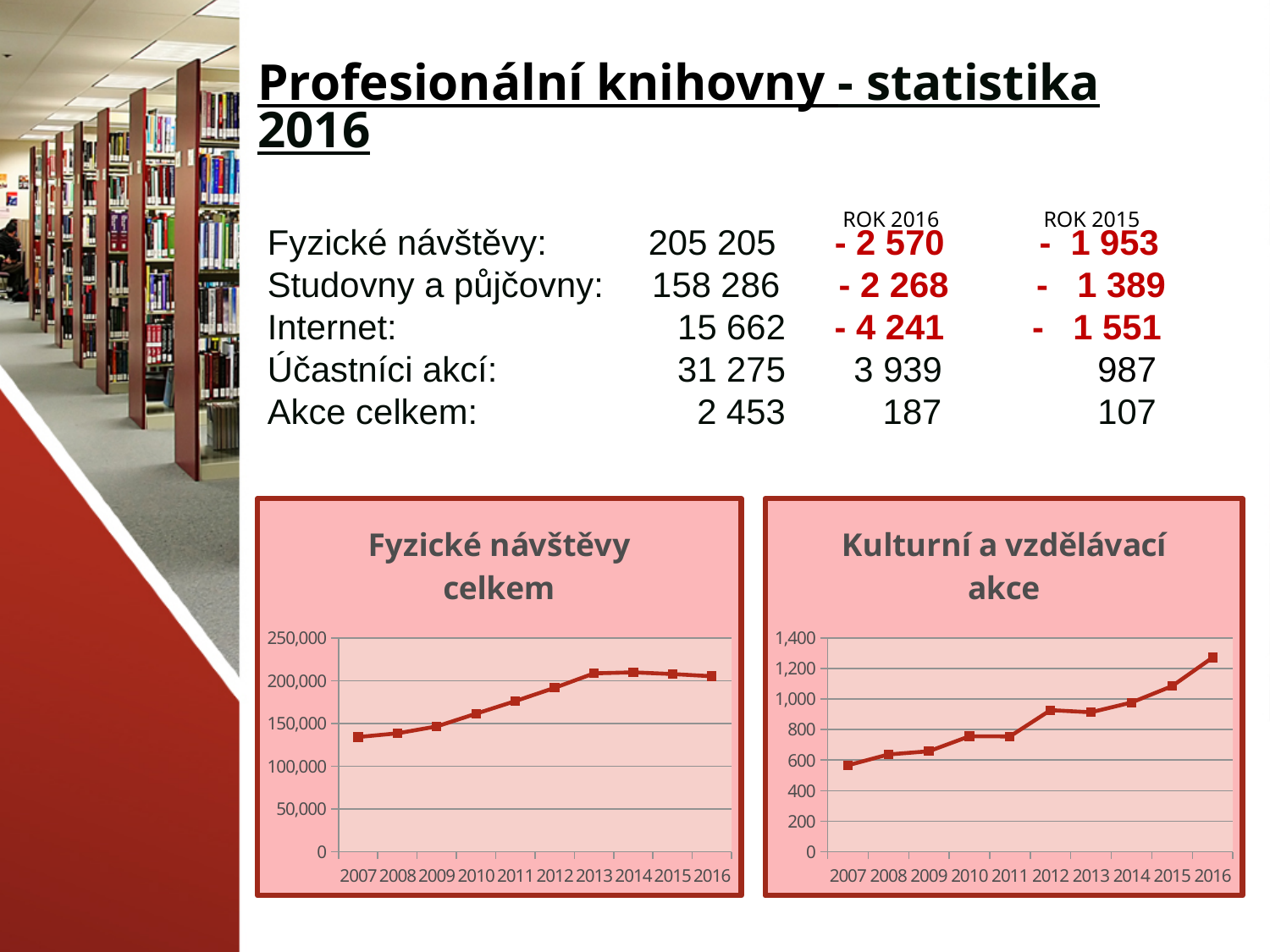
In the "Kulturní a vzdělávací akce" chart, do the values generally rise or fall from 2007 to 2016? rise In the "Fyzické návštěvy celkem" chart, which year has the lowest value? 2007 What kind of chart is the "Fyzické návštěvy celkem" chart? line chart In the "Kulturní a vzdělávací akce" chart, is the value for 2016 greater or less than 1,200? greater In the "Kulturní a vzdělávací akce" chart, which year has the lowest value? 2007 In the "Fyzické návštěvy celkem" chart, is the value for 2016 greater or less than 200,000? greater How many years are plotted on the x axis of the "Kulturní a vzdělávací akce" chart? 10 In the "Fyzické návštěvy celkem" chart, which year has the larger value, 2007 or 2012? 2012 In the "Kulturní a vzdělávací akce" chart, which year has the larger value, 2010 or 2015? 2015 In the "Kulturní a vzdělávací akce" chart, which year has the highest value? 2016 In the "Fyzické návštěvy celkem" chart, is the value for 2007 greater or less than 150,000? less